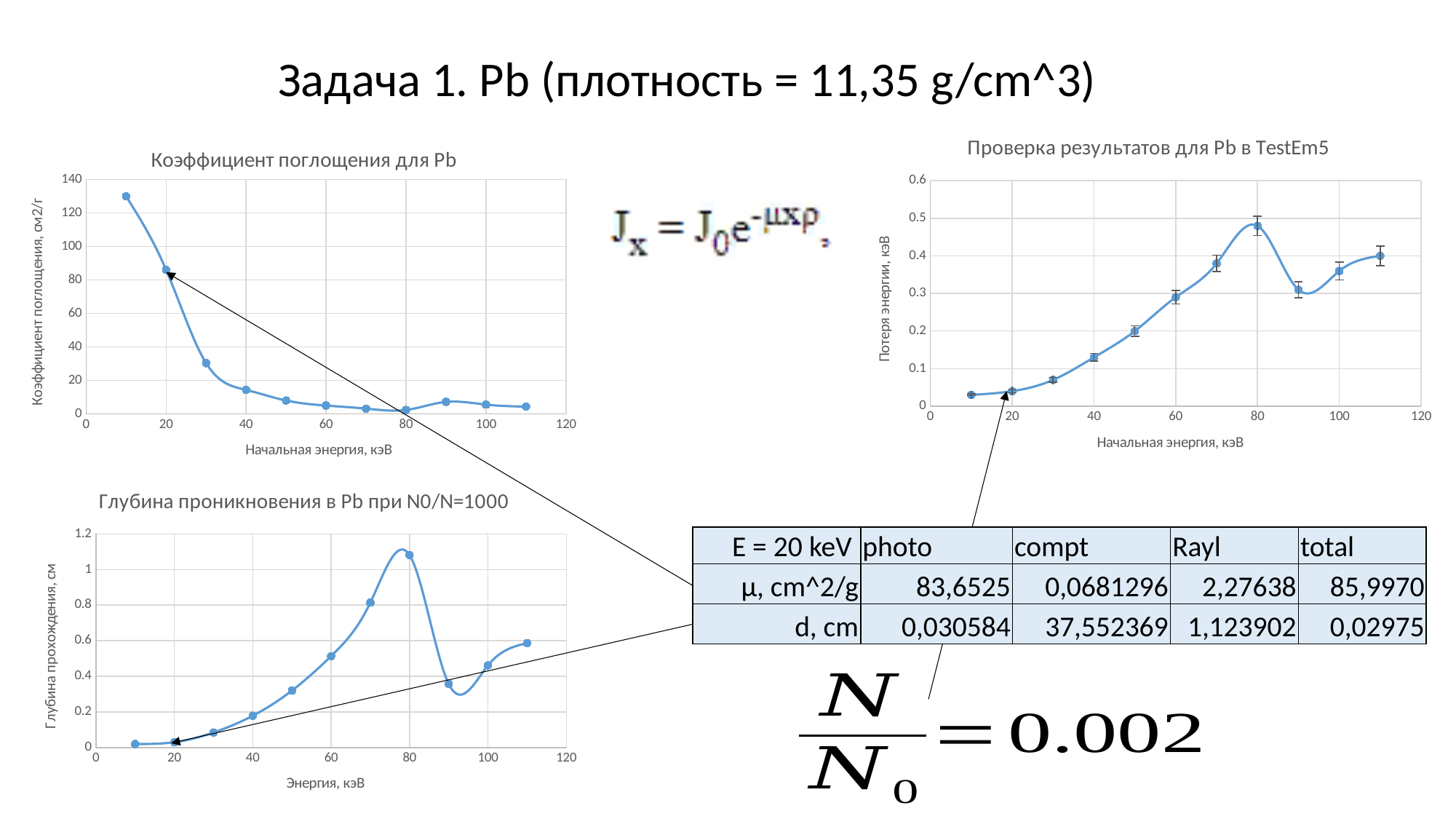
How many data points are plotted in the chart "Коэффициент поглощения для Pb"? 11 In the chart "Глубина проникновения в Pb при N0/N=1000", which is larger: the value at 60 кэВ or the value at 90 кэВ? 60 кэВ In the chart "Проверка результатов для Pb в TestEm5", at which energy is the energy loss highest? 80 кэВ In the chart "Коэффициент поглощения для Pb", do the values generally rise or fall as energy increases from 10 to 60 кэВ? fall What is the x-axis label of the chart "Проверка результатов для Pb в TestEm5"? Начальная энергия, кэВ In the chart "Глубина проникновения в Pb при N0/N=1000", is the value at 80 кэВ greater or less than 1? greater In the chart "Коэффициент поглощения для Pb", is the value at 30 кэВ greater or less than 40? less What kind of chart is "Коэффициент поглощения для Pb"? line chart In the chart "Коэффициент поглощения для Pb", at which energy is the absorption coefficient highest? 10 кэВ In the chart "Коэффициент поглощения для Pb", is the value at 10 кэВ greater or less than 120? greater In the chart "Глубина проникновения в Pb при N0/N=1000", at which energy is the penetration depth highest? 80 кэВ